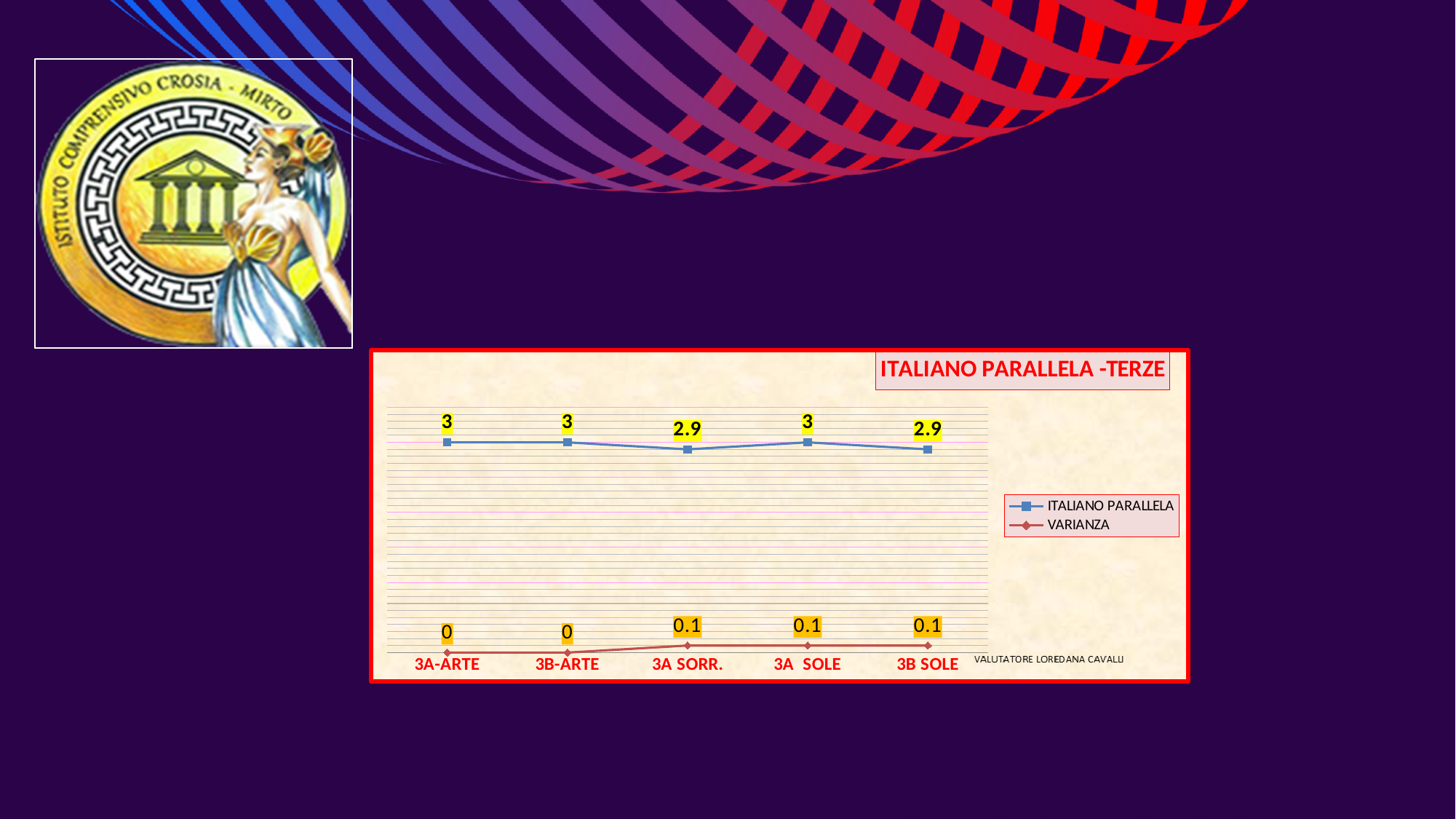
What is the title of the chart? ITALIANO PARALLELA -TERZE Which series is drawn in red? VARIANZA What is the VARIANZA value for 3B SOLE? 0.1 How many series does the legend list? 2 Is the ITALIANO PARALLELA value for 3A SOLE larger than the value for 3A SORR.? Yes Which category has the lowest VARIANZA value, 3A-ARTE or 3A SORR.? 3A-ARTE How many categories are shown on the x axis? 5 What is the difference between the ITALIANO PARALLELA values for 3B-ARTE and 3B SOLE? 0.1 What kind of chart is shown? Line chart What is the ITALIANO PARALLELA value for 3A-ARTE? 3 What is the ITALIANO PARALLELA value for 3A SORR.? 2.9 What is the VARIANZA value for 3B-ARTE? 0